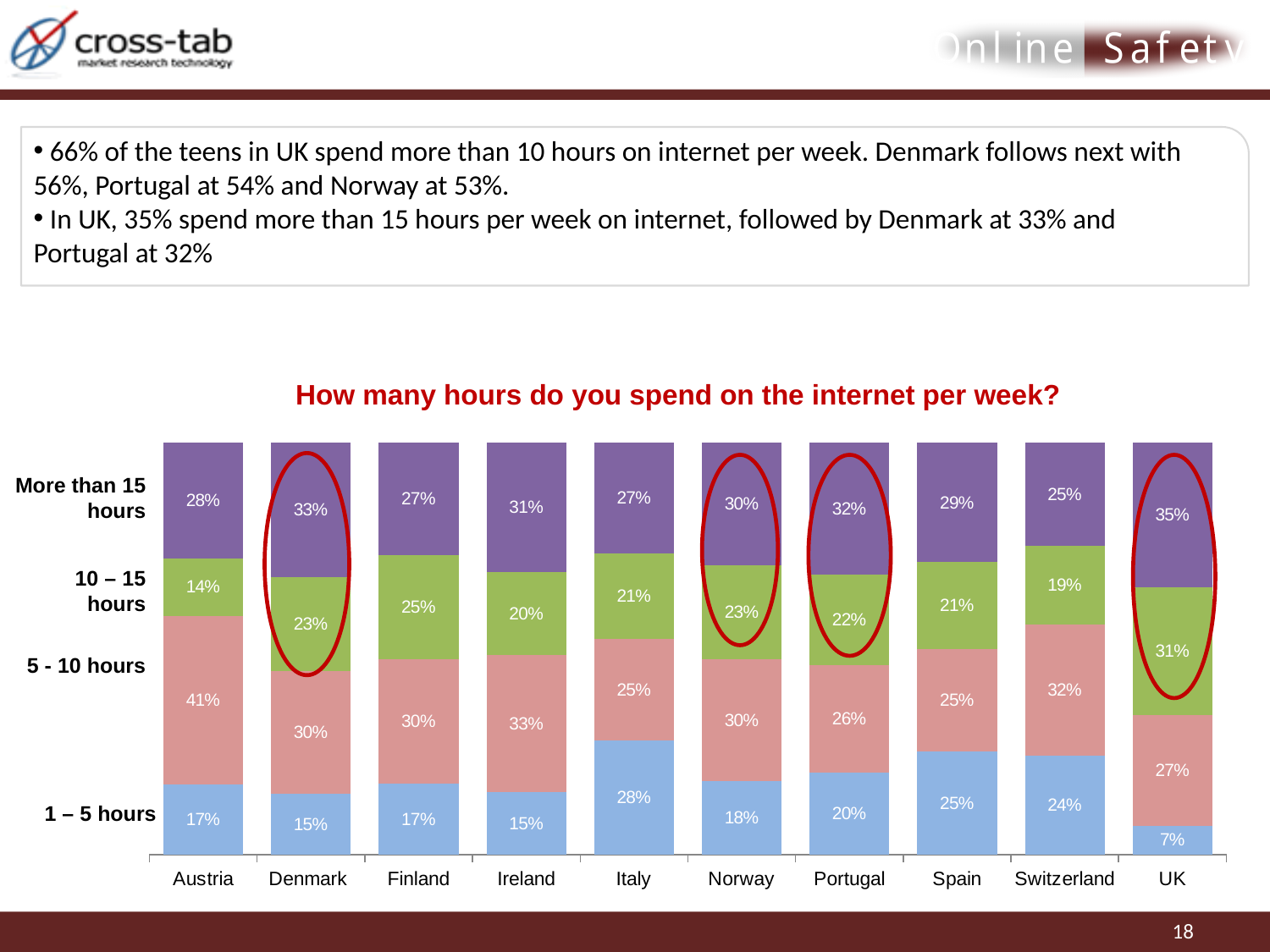
What kind of chart is shown on the slide? Stacked bar chart What is the combined share of Denmark teens in the 10 – 15 hours and More than 15 hours categories? 56% How many countries are shown on the x axis of the chart? 10 Which country has the highest share of teens spending more than 15 hours per week on the internet? UK Which country has a larger share in the 1 – 5 hours category, Italy or Spain? Italy How many hour-range categories (series) are stacked in each bar? 4 What is the title of the chart? How many hours do you spend on the internet per week? What is the value for the 10 – 15 hours segment for Switzerland? 19% What percentage of teens in the UK spend more than 15 hours on the internet per week? 35% What is the value for the 5 - 10 hours segment for Austria? 41% What is the difference between the UK and Denmark in the 'More than 15 hours' category? 2 percentage points Which country has the lowest share in the 1 – 5 hours category? UK